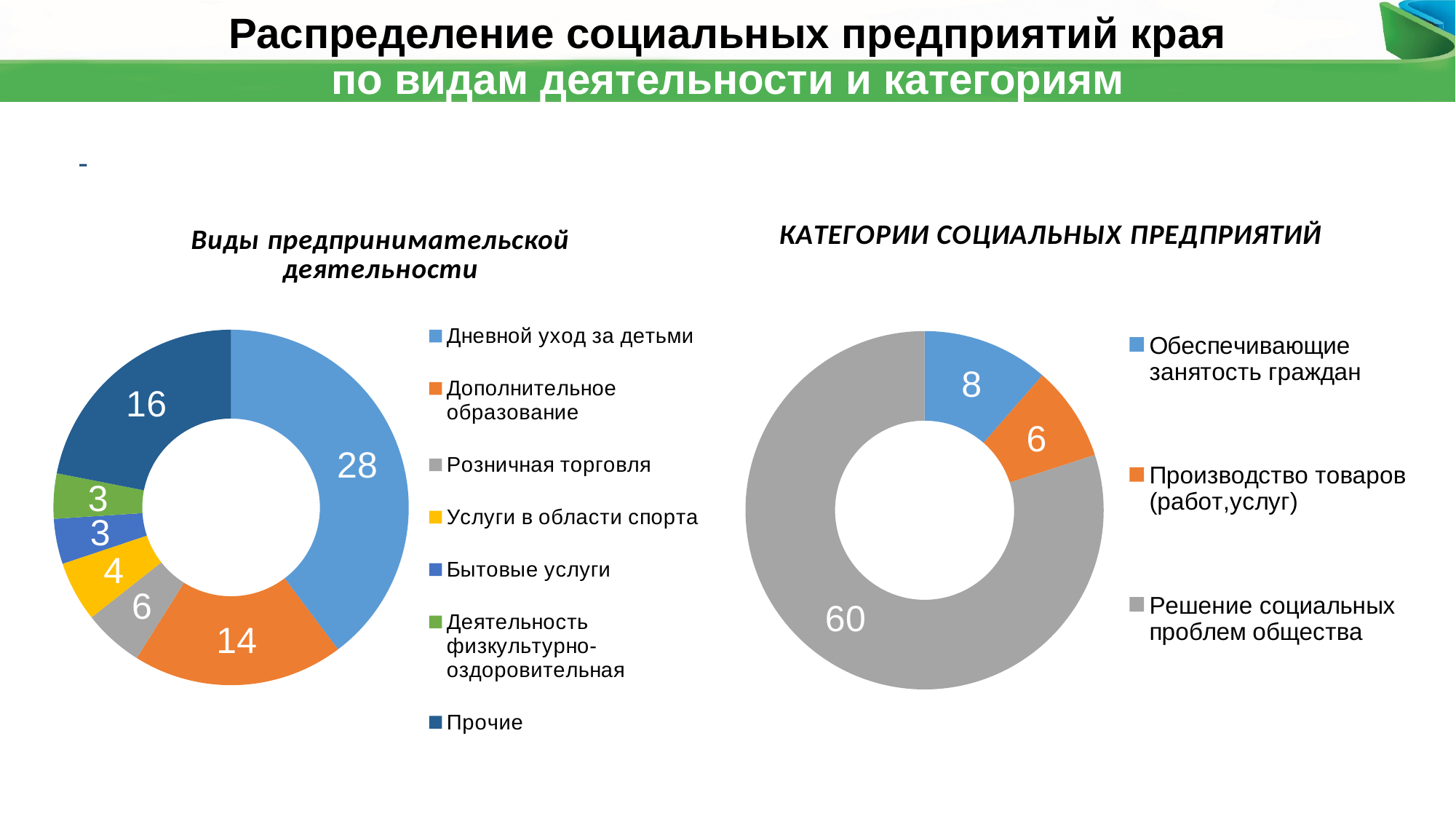
In the chart 'Виды предпринимательской деятельности', which category has the largest value? Дневной уход за детьми In the chart 'Виды предпринимательской деятельности', which is larger: 'Розничная торговля' or 'Услуги в области спорта'? Розничная торговля In the chart 'КАТЕГОРИИ СОЦИАЛЬНЫХ ПРЕДПРИЯТИЙ', which category has the smallest value? Производство товаров (работ,услуг) What type of chart is 'КАТЕГОРИИ СОЦИАЛЬНЫХ ПРЕДПРИЯТИЙ'? Doughnut chart In the chart 'Виды предпринимательской деятельности', what is the value for 'Прочие'? 16 How many categories are shown in the chart 'КАТЕГОРИИ СОЦИАЛЬНЫХ ПРЕДПРИЯТИЙ'? 3 In the chart 'Виды предпринимательской деятельности', what colour is the slice for 'Дополнительное образование'? Orange In the chart 'Виды предпринимательской деятельности', what is the difference between 'Дневной уход за детьми' and 'Дополнительное образование'? 14 In the chart 'КАТЕГОРИИ СОЦИАЛЬНЫХ ПРЕДПРИЯТИЙ', what is the value for 'Решение социальных проблем общества'? 60 In the chart 'Виды предпринимательской деятельности', what is the value for 'Дневной уход за детьми'? 28 In the chart 'КАТЕГОРИИ СОЦИАЛЬНЫХ ПРЕДПРИЯТИЙ', what is the difference between 'Решение социальных проблем общества' and 'Обеспечивающие занятость граждан'? 52 How many categories does the legend of the chart 'Виды предпринимательской деятельности' list? 7